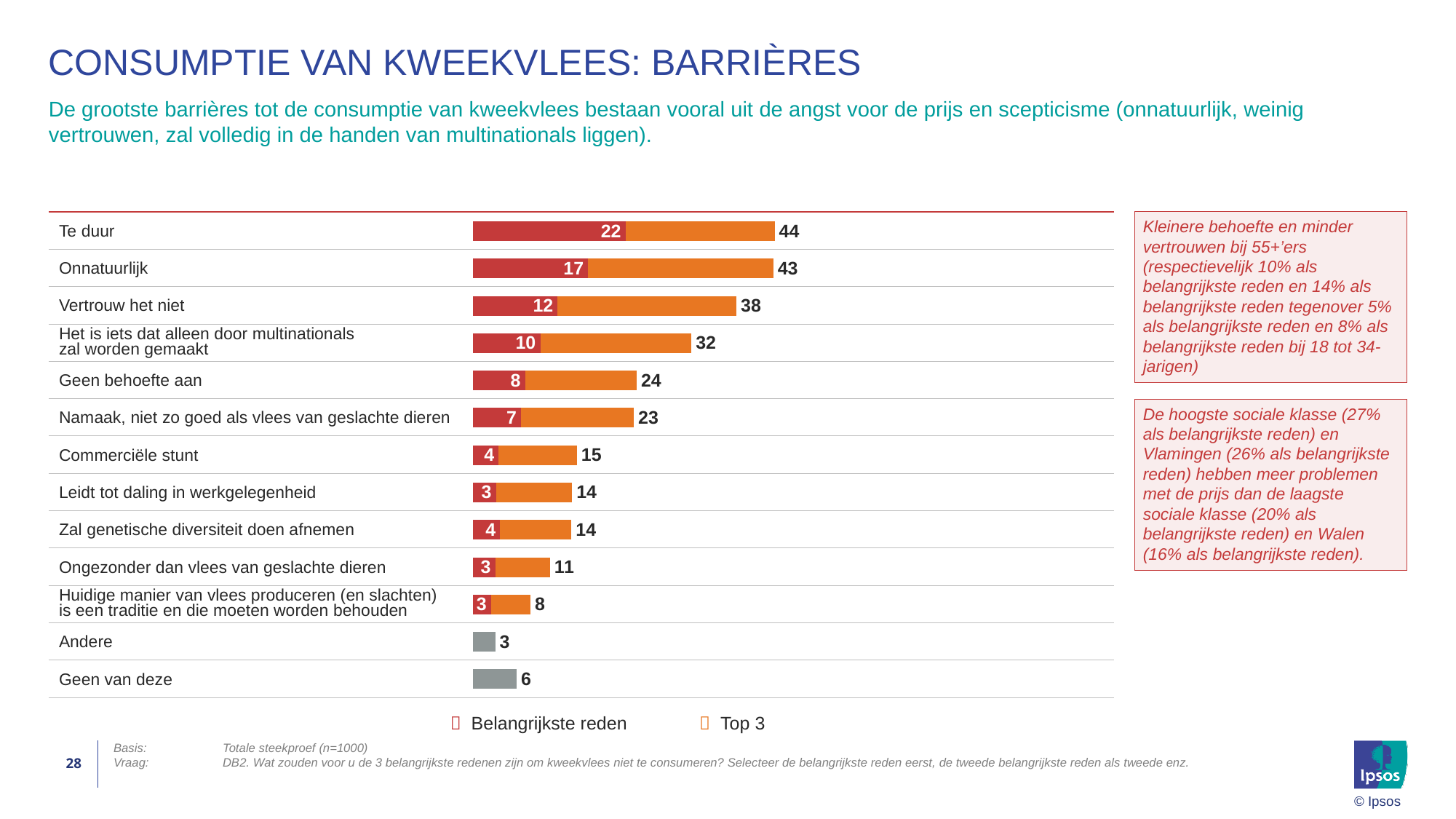
What is the difference between the 'Belangrijkste reden' values for 'Te duur' and 'Geen behoefte aan'? 14 What is the 'Belangrijkste reden' value for 'Vertrouw het niet'? 12 Which has the larger 'Top 3' value: 'Commerciële stunt' or 'Leidt tot daling in werkgelegenheid'? Commerciële stunt What value is shown for 'Geen van deze'? 6 What is the 'Top 3' value shown at the end of the bar for 'Onnatuurlijk'? 43 Which category has the highest 'Top 3' value? Te duur What kind of chart is shown on the slide? Bar chart Which category has the lowest value shown at the end of its bar? Andere How many categories are shown in the chart? 13 What is the 'Belangrijkste reden' value for 'Te duur'? 22 What is the difference between the 'Top 3' values for 'Te duur' and 'Onnatuurlijk'? 1 How many series does the legend list? 2